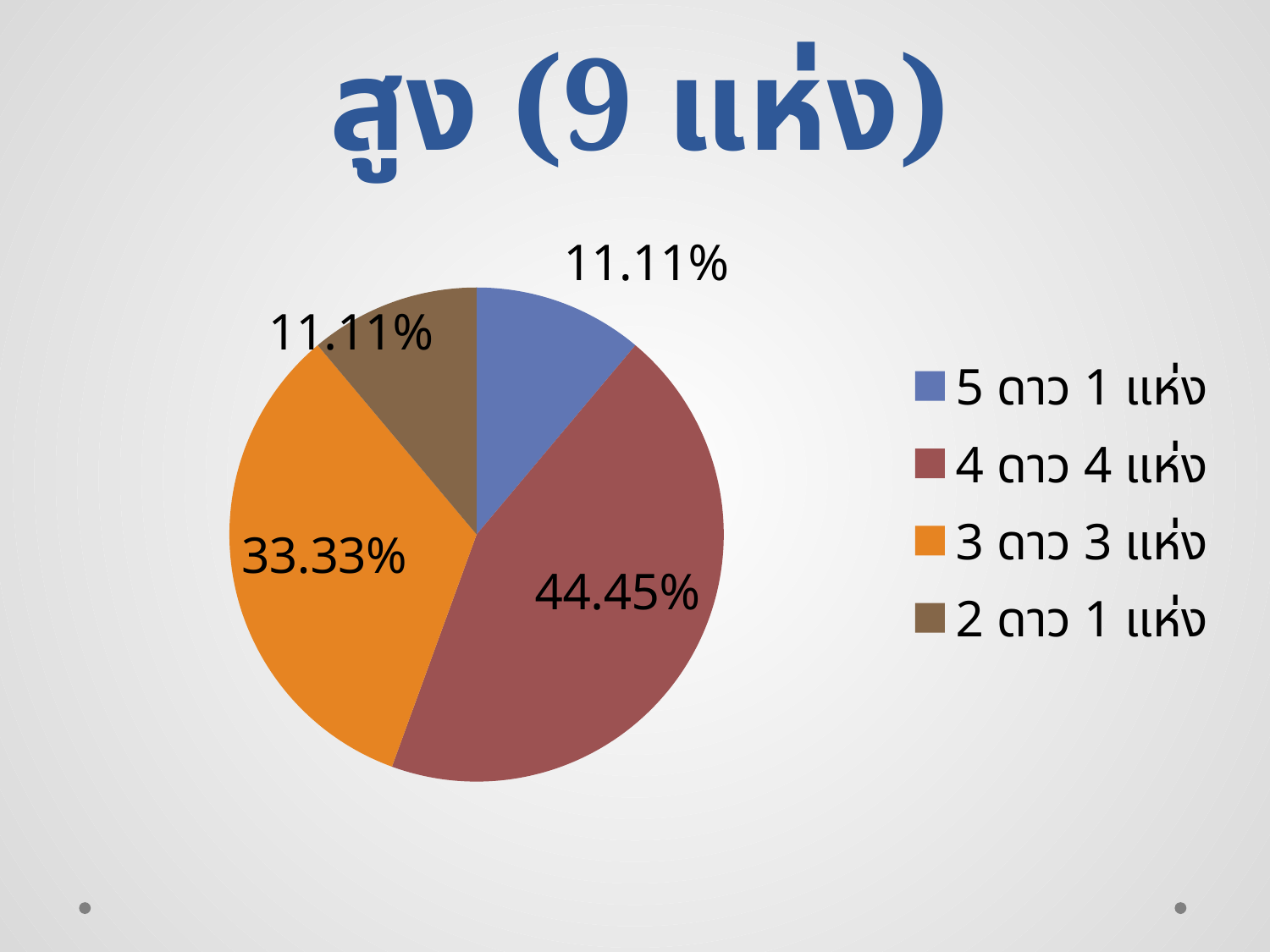
What percentage is shown for the slice labelled 3 ดาว 3 แห่ง? 33.33% What type of chart is shown on the slide? pie chart What percentage is shown for the slice labelled 5 ดาว 1 แห่ง? 11.11% Which legend category has the largest share of the pie? 4 ดาว 4 แห่ง How many slices does the pie chart have? 4 What is the difference in percentage points between the 4 ดาว 4 แห่ง slice and the 3 ดาว 3 แห่ง slice? 11.12 What percentage is shown for the slice labelled 2 ดาว 1 แห่ง? 11.11% What is the combined share of the 5 ดาว 1 แห่ง and 2 ดาว 1 แห่ง slices? 22.22% Which slice is larger: 3 ดาว 3 แห่ง or 5 ดาว 1 แห่ง? 3 ดาว 3 แห่ง What is the title of the chart? สูง (9 แห่ง) What colour is the slice for 3 ดาว 3 แห่ง? orange What percentage is shown for the slice labelled 4 ดาว 4 แห่ง? 44.45%